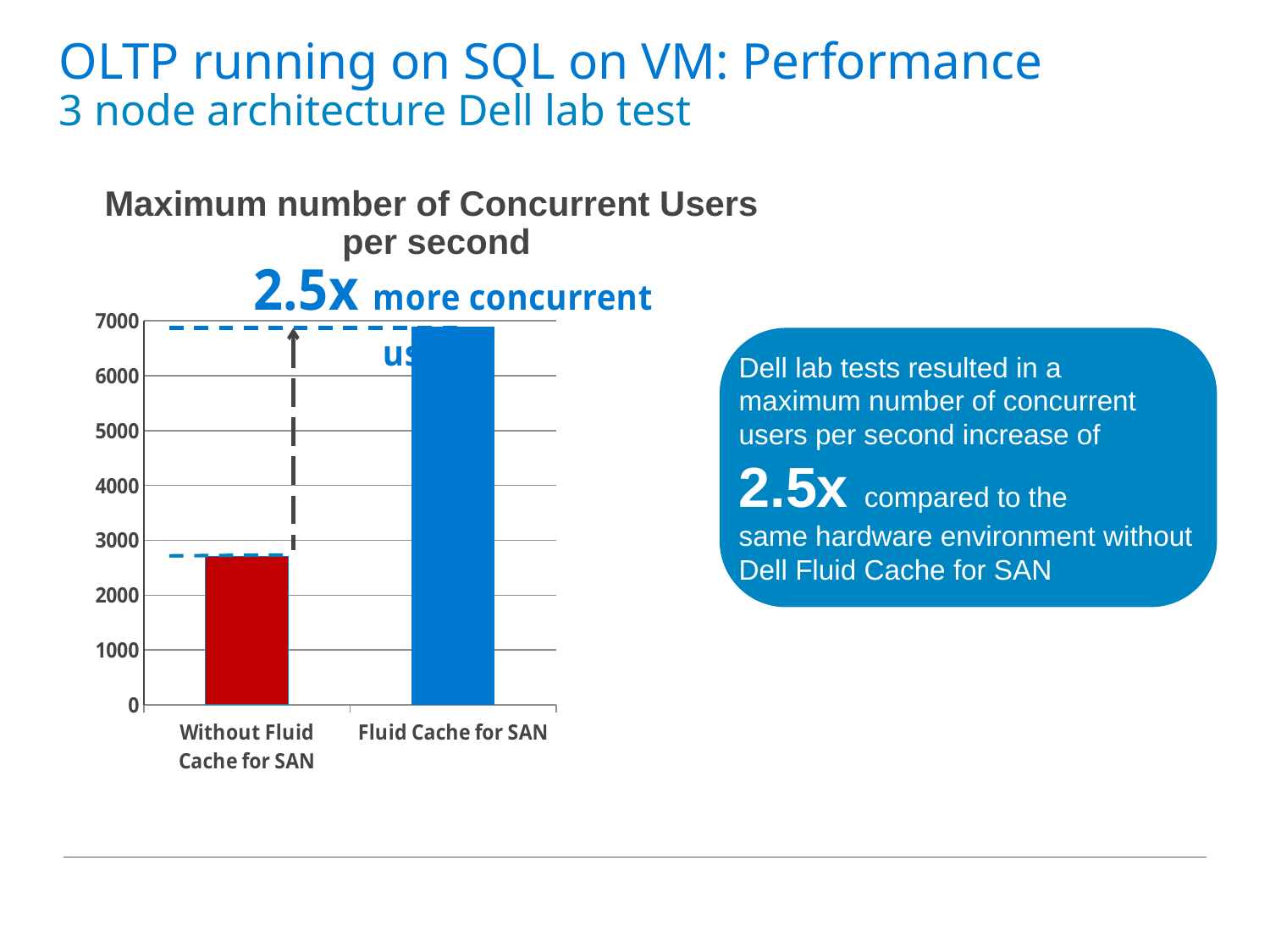
Is the value for Fluid Cache for SAN greater or less than 5000? greater Is the value for Fluid Cache for SAN greater or less than 6000? greater What kind of chart is shown on the slide? bar chart Which is larger: the value for Without Fluid Cache for SAN or the value for Fluid Cache for SAN? Fluid Cache for SAN How many categories are plotted in the chart? 2 What colour is the bar for Without Fluid Cache for SAN? red What is the title of the chart? Maximum number of Concurrent Users per second Is the value for Without Fluid Cache for SAN greater or less than 2000? greater What is the highest value shown on the chart's vertical axis? 7000 Which category has the highest value in the chart? Fluid Cache for SAN Which category has the lowest value in the chart? Without Fluid Cache for SAN